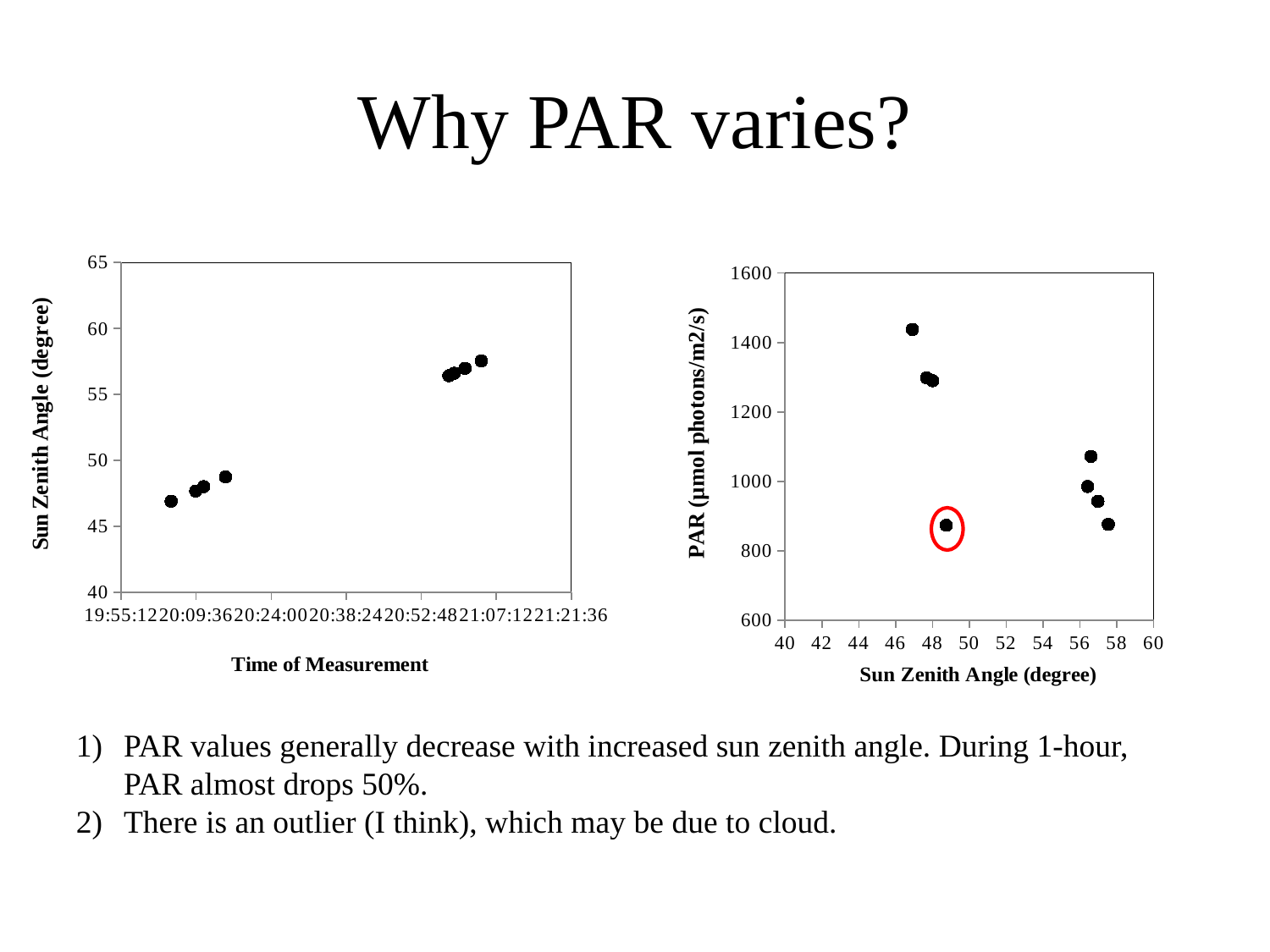
In the right chart, does PAR generally rise or fall as the sun zenith angle increases? fall In the left chart, is the sun zenith angle of the earliest measurement greater or less than 50? less How many data points are plotted in the right chart (PAR vs Sun Zenith Angle)? 8 In the right chart, is the highest PAR value greater or less than 1400? greater In the right chart, is the PAR value of the point circled in red greater or less than 1000? less What is the x-axis label of the left chart? Time of Measurement What is the y-axis label of the right chart? PAR (µmol photons/m2/s) What kind of chart is the left chart (Sun Zenith Angle vs Time of Measurement)? scatter chart In the left chart, does the sun zenith angle rise or fall as the time of measurement increases? rise What kind of chart is the right chart (PAR vs Sun Zenith Angle)? scatter chart